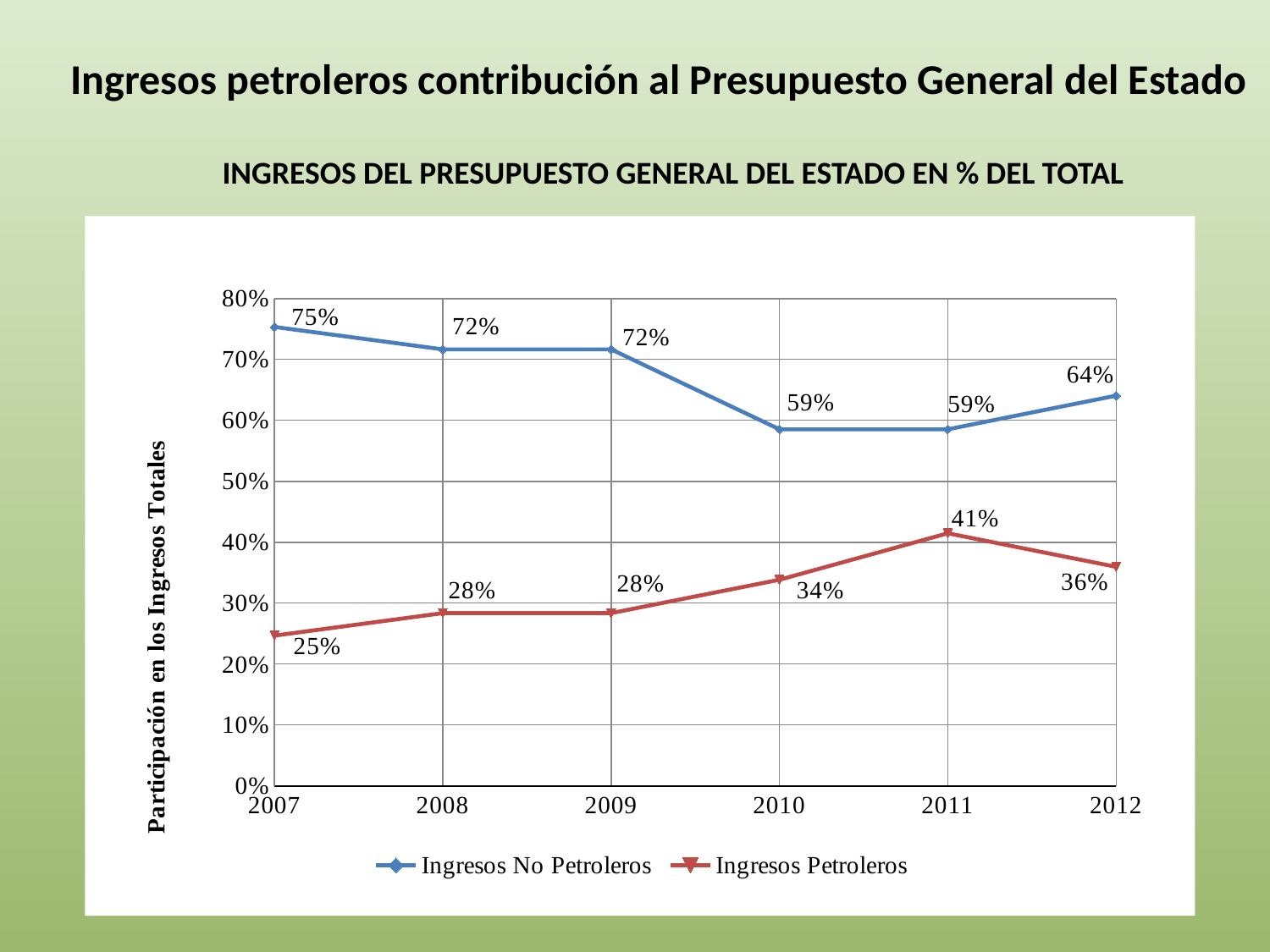
How many years are shown on the x axis? 6 In which year is Ingresos Petroleros lowest? 2007 What is the difference between Ingresos No Petroleros and Ingresos Petroleros in 2010? 25% How many series does the legend list? 2 What type of chart is shown on the slide? line chart In which year is Ingresos Petroleros highest? 2011 Which series has the larger value in 2012, Ingresos No Petroleros or Ingresos Petroleros? Ingresos No Petroleros What is the value for Ingresos No Petroleros in 2007? 75% Is the value for Ingresos Petroleros in 2010 greater or less than 30%? greater What is the value for Ingresos Petroleros in 2011? 41% Does Ingresos No Petroleros rise or fall from 2007 to 2010? fall What is the value for Ingresos Petroleros in 2012? 36%